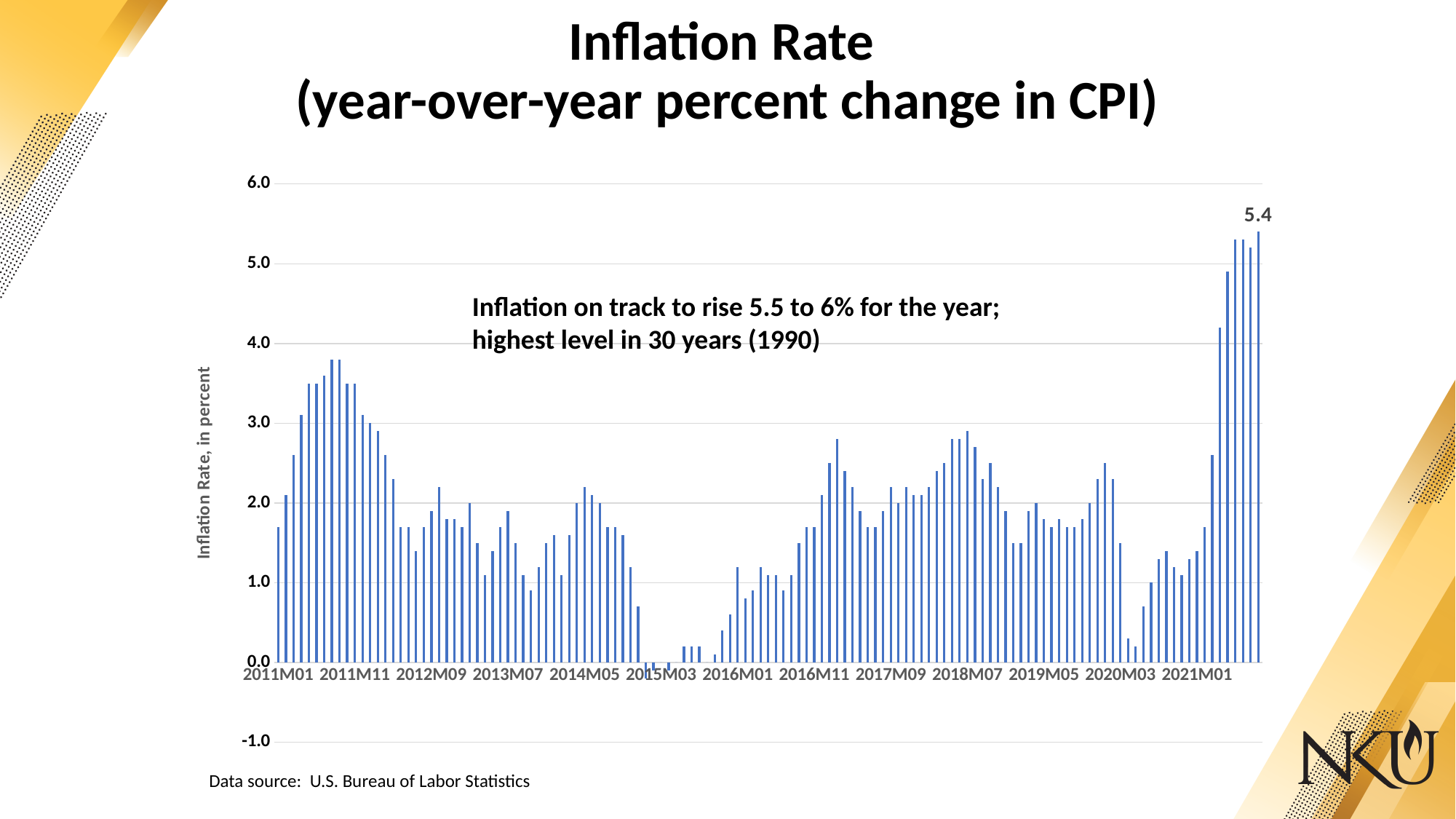
Do the values rise or fall from 2021M01 to the end of the chart? rise Which has the larger value, 2018M07 or 2021M01? 2018M07 What is the title of the vertical axis? Inflation Rate, in percent What is the value printed on the last bar of the chart? 5.4 Is the value for 2021M01 greater or less than 2.0? less What data source is cited for the chart? U.S. Bureau of Labor Statistics Is the value for 2015M03 greater or less than 1.0? less What is the highest inflation rate value shown on the chart? 5.4 Which has the larger value, 2011M11 or 2015M03? 2011M11 What kind of chart is shown on the slide? bar chart Is the value for 2011M11 greater or less than 3.0? greater